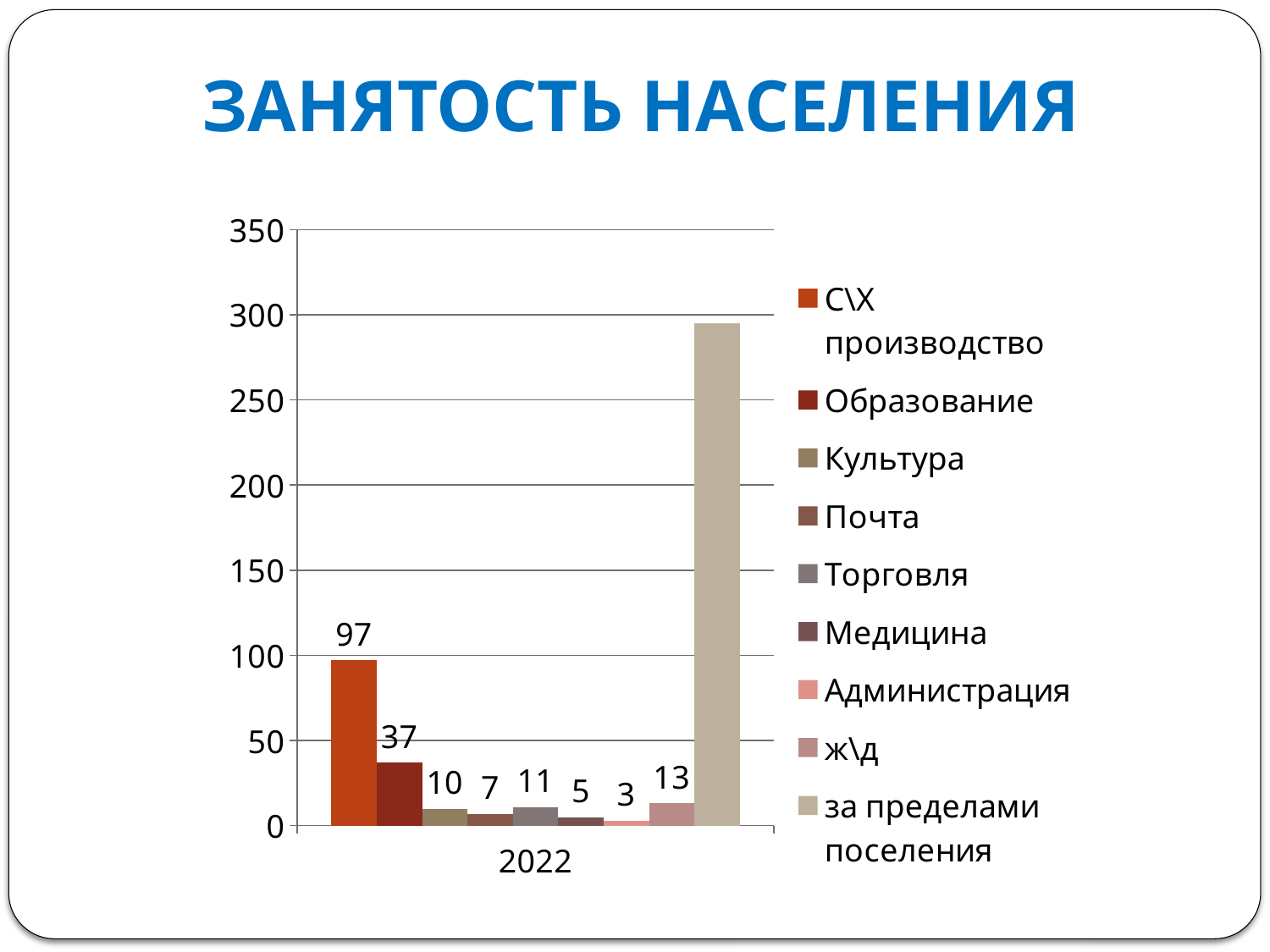
What is the value for С\Х производство in 2022? 97 Which series has the highest value in 2022? за пределами поселения Is the value for за пределами поселения greater or less than 250? greater How many series does the legend list? 9 Which is larger, the value for Почта or the value for Торговля? Торговля What is the value for ж\д in 2022? 13 What is the value for Торговля in 2022? 11 Which series has the lowest value in 2022? Администрация What is the difference between the values for С\Х производство and Образование? 60 What is the title of the slide? ЗАНЯТОСТЬ НАСЕЛЕНИЯ What is the value for Образование in 2022? 37 What kind of chart is shown on the slide? bar chart